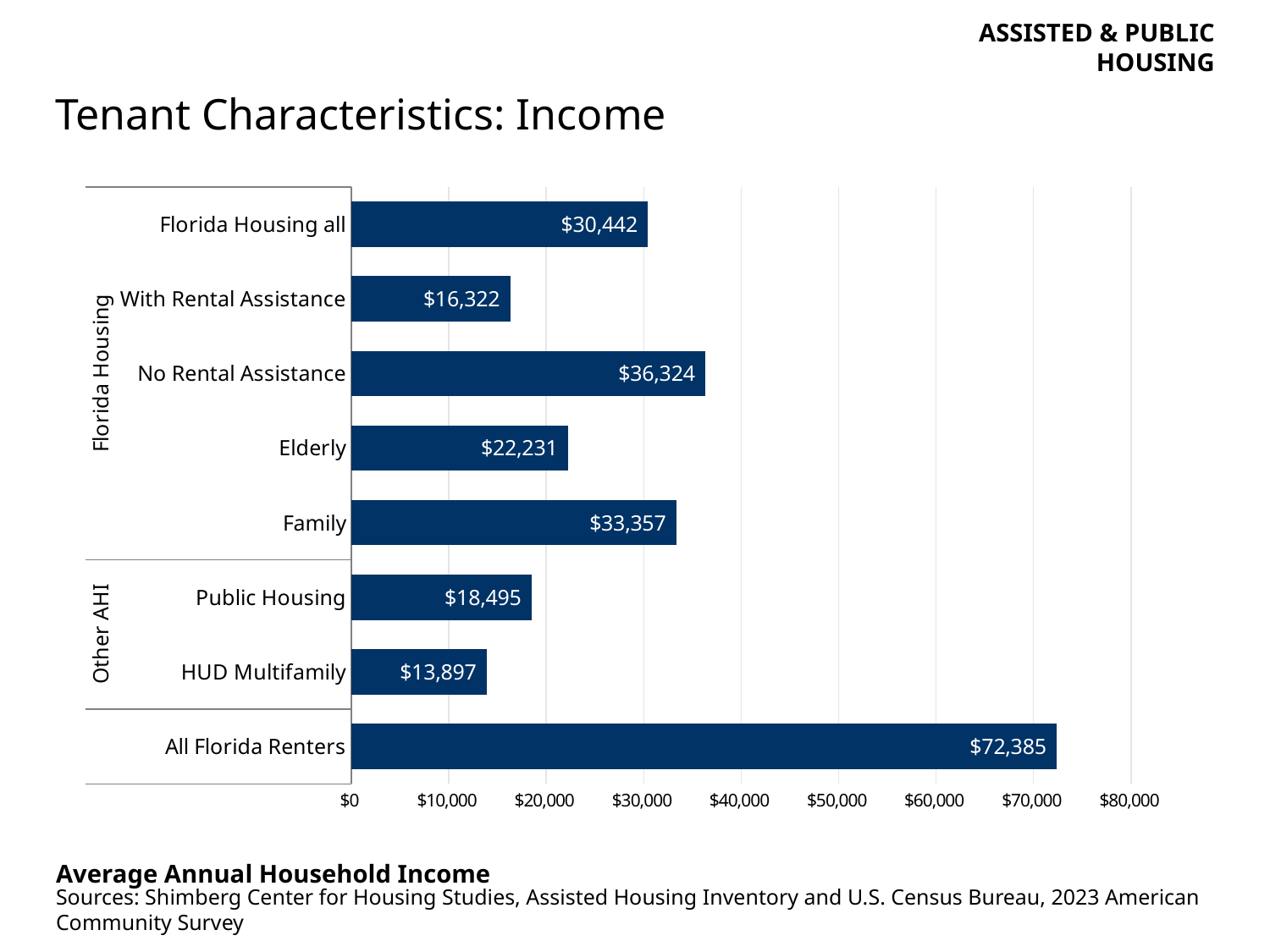
What kind of chart is shown on the slide? Bar chart What is the average annual household income for Elderly? $22,231 What is the average annual household income for HUD Multifamily? $13,897 Which is larger, the average annual household income for Family or for Public Housing? Family What is the title of the slide? Tenant Characteristics: Income What is the average annual household income for Florida Housing all? $30,442 Which category has the lowest average annual household income? HUD Multifamily Which category has the highest average annual household income? All Florida Renters Is the value for Public Housing greater or less than $20,000? less What is the difference between the average annual household income for No Rental Assistance and With Rental Assistance? $20,002 What is the difference between the average annual household income for All Florida Renters and Florida Housing all? $41,943 How many categories are shown in the chart? 8